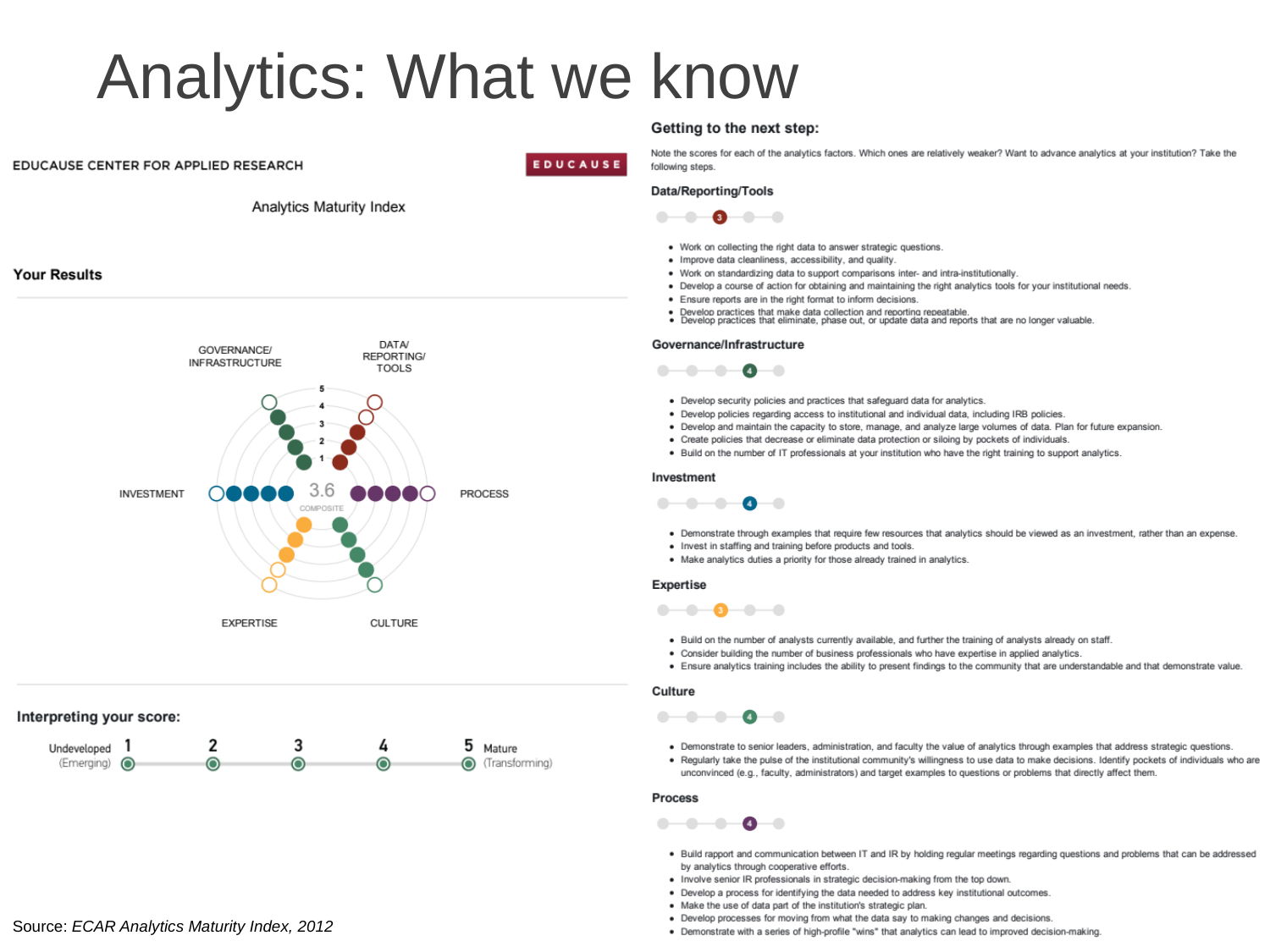
What is the composite score shown at the centre of the Analytics Maturity Index chart? 3.6 What score is shown for Data/Reporting/Tools? 3 What is the difference between the Culture score and the Data/Reporting/Tools score? 1 Is the composite score greater or less than 3? greater What kind of chart is used to display the six analytics factor scores? radar chart What is the maximum value on the maturity scale shown in the chart? 5 What is the title of the chart on the left of the slide? Analytics Maturity Index What score is shown for Process? 4 What score is shown for Expertise? 3 What score is shown for Governance/Infrastructure? 4 Which has the higher score, Governance/Infrastructure or Expertise? Governance/Infrastructure How many analytics factors are plotted around the Analytics Maturity Index chart? 6